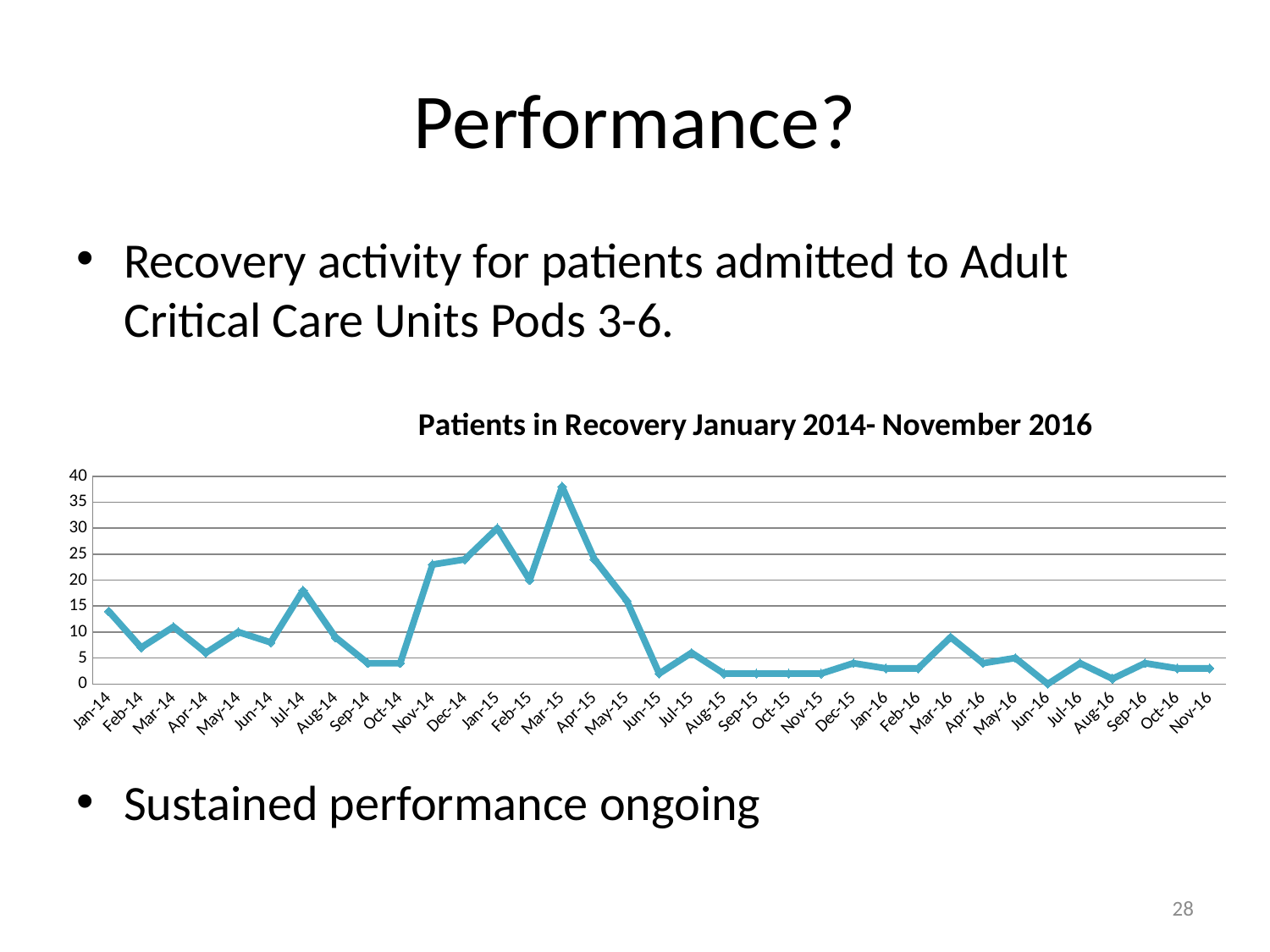
Which month has the lowest number of patients in recovery? Jun-16 Is the value for Jul-14 greater or less than 15? greater Is the value for Sep-14 greater or less than 5? less Do the values generally rise or fall from Mar-15 to Nov-16? fall Which is larger, the value for Jan-15 or the value for Feb-15? Jan-15 How many monthly data points are plotted on the chart? 35 Is the value for Mar-15 greater or less than 35? greater Which month has the highest number of patients in recovery? Mar-15 What is the title of the chart? Patients in Recovery January 2014- November 2016 What kind of chart is shown on the slide? line chart Which is larger, the value for Jan-14 or the value for Nov-14? Nov-14